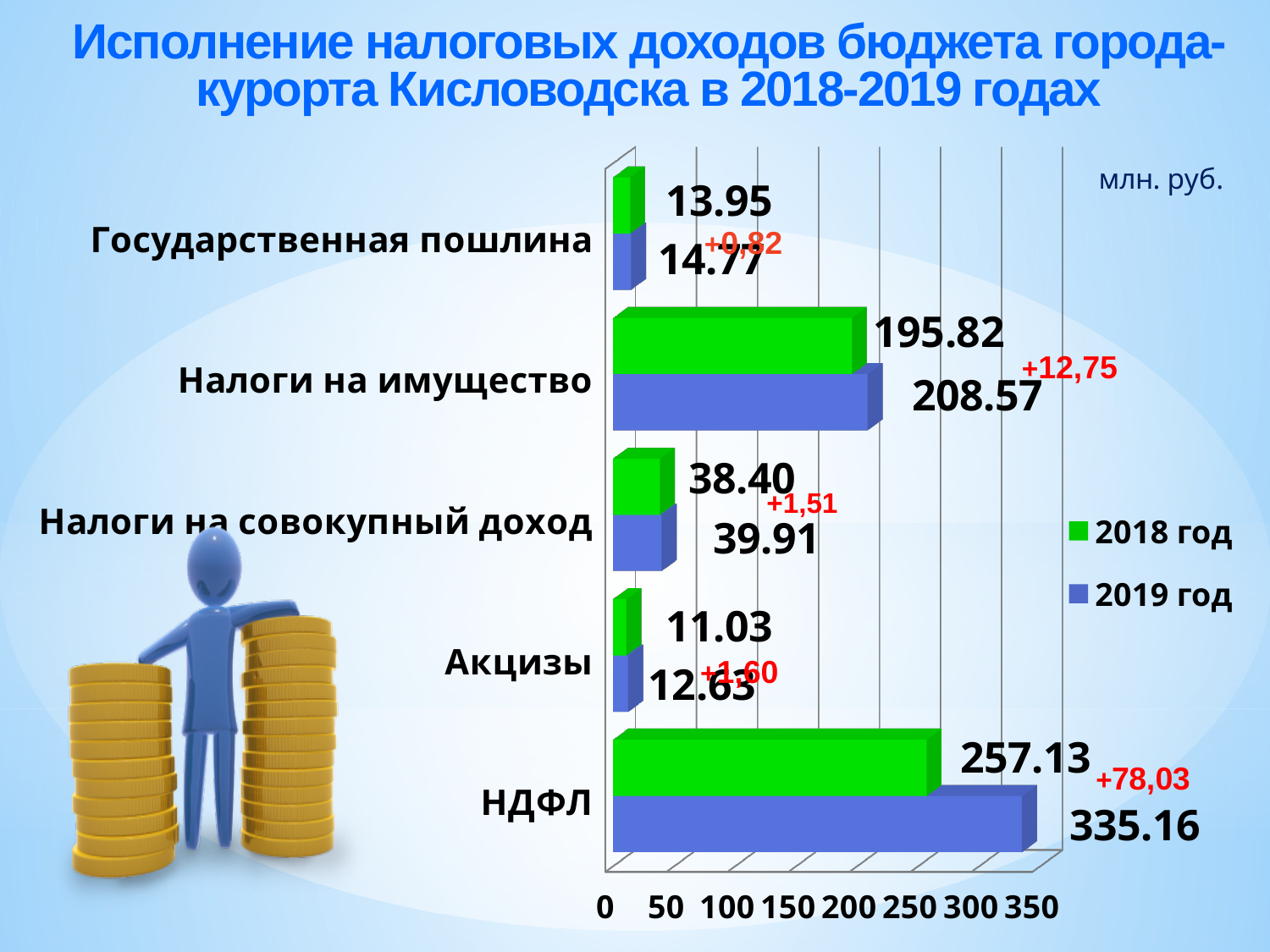
What is the value for Налоги на совокупный доход in 2018 год? 38.40 What is the difference between the 2019 год and 2018 год values for НДФЛ? 78.03 What kind of chart is shown on the slide? Bar chart Which category has the highest value in 2019 год? НДФЛ Which is larger for Налоги на имущество: the 2018 год value or the 2019 год value? 2019 год How many series does the legend list? 2 What is the value for Акцизы in 2019 год? 12.63 What unit is indicated for the chart values? млн. руб. How many categories are shown on the chart? 5 What is the value for Налоги на имущество in 2018 год? 195.82 What is the value for НДФЛ in 2019 год? 335.16 Which category has the lowest value in 2018 год? Акцизы